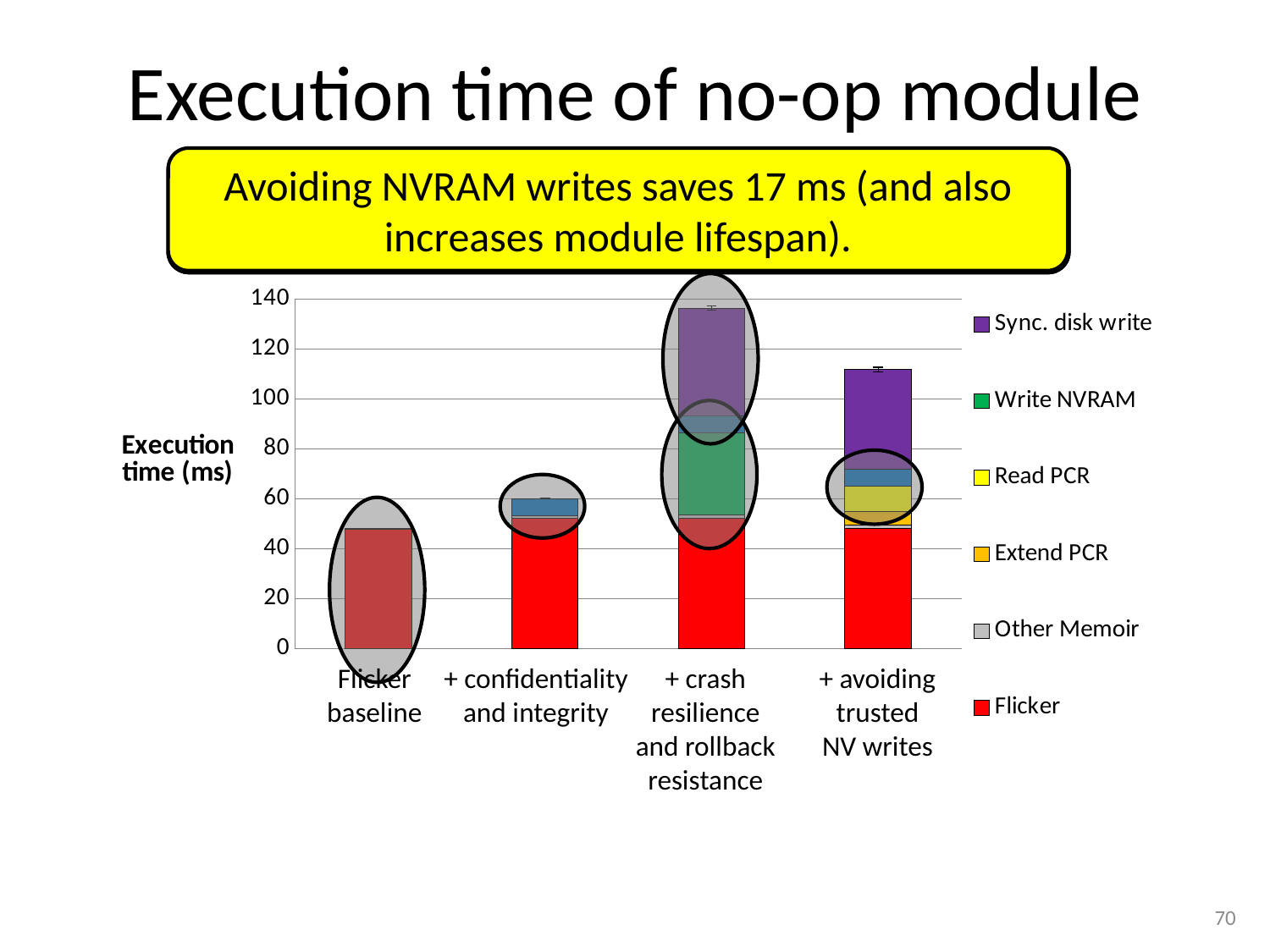
Which category has the highest total execution time? + crash resilience and rollback resistance Is the total execution time for + avoiding trusted NV writes greater or less than 100? greater What kind of chart is shown on the slide? stacked bar chart Which series is listed first (at the top) in the chart's legend? Sync. disk write How many series does the chart's legend list? 6 Is the total execution time for + confidentiality and integrity greater or less than 40? greater Which has a larger total execution time: + crash resilience and rollback resistance or + avoiding trusted NV writes? + crash resilience and rollback resistance Is the total execution time for + crash resilience and rollback resistance greater or less than 120? greater What is the label on the vertical axis of the chart? Execution time (ms) How many categories are shown along the x axis of the chart? 4 Which category has the lowest total execution time? Flicker baseline